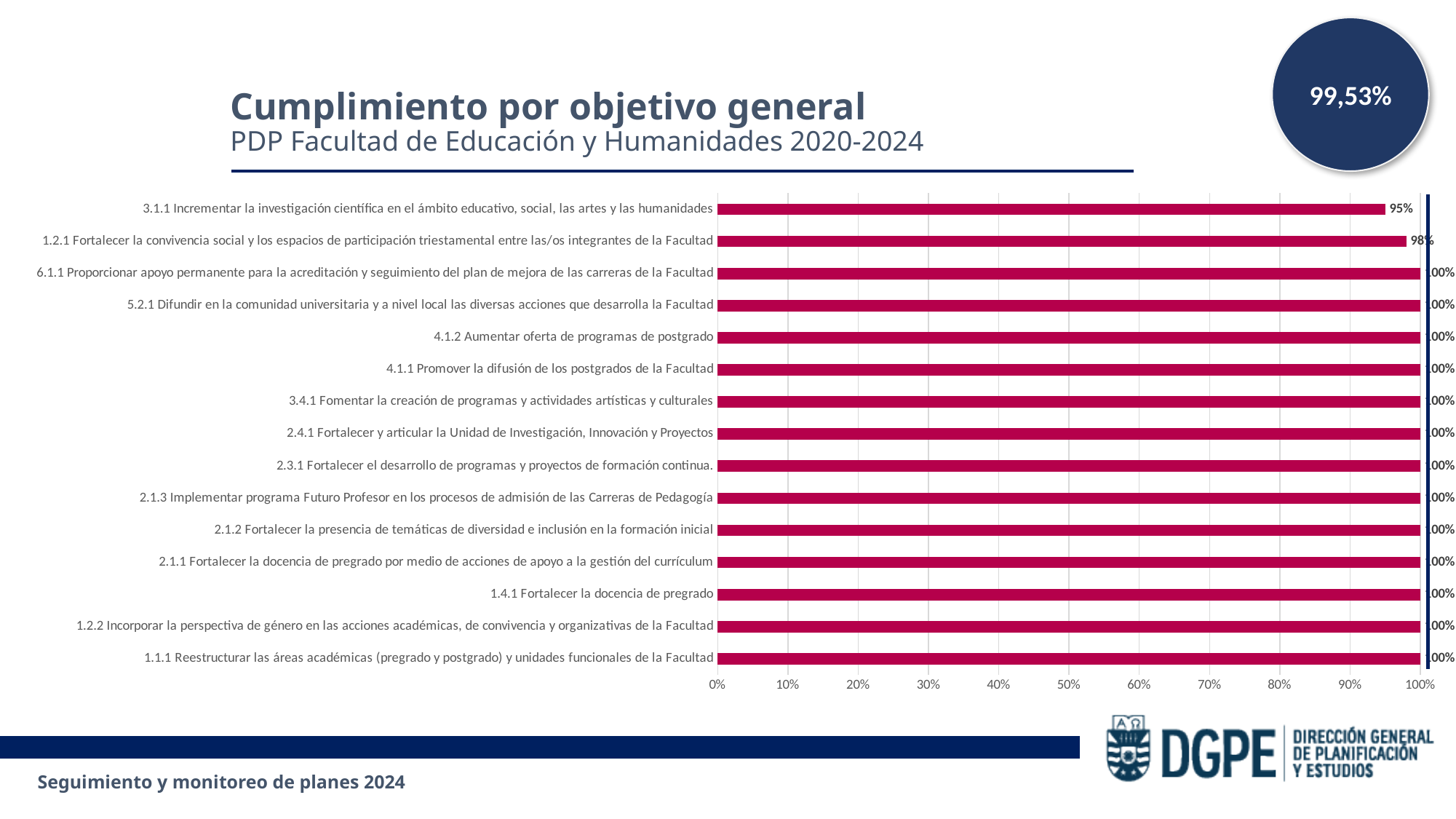
Is the value for objective 3.1.1 greater or less than 90%? greater What is the title of the chart? Cumplimiento por objetivo general What is the difference between the values for objective 1.2.1 and objective 3.1.1? 3% What is the value for objective 1.2.1 Fortalecer la convivencia social y los espacios de participación triestamental entre las/os integrantes de la Facultad? 98% What is the value for objective 1.4.1 Fortalecer la docencia de pregrado? 100% How many objectives have a value of 100%? 13 What is the value for objective 3.1.1 Incrementar la investigación científica en el ámbito educativo, social, las artes y las humanidades? 95% Which objective has the lowest value in the chart? 3.1.1 Incrementar la investigación científica en el ámbito educativo, social, las artes y las humanidades Which is larger, the value for objective 1.2.1 or the value for objective 3.1.1? 1.2.1 What kind of chart is shown on the slide? bar chart What overall percentage is shown in the circle at the top right of the slide? 99,53% How many objectives are plotted in the chart? 15